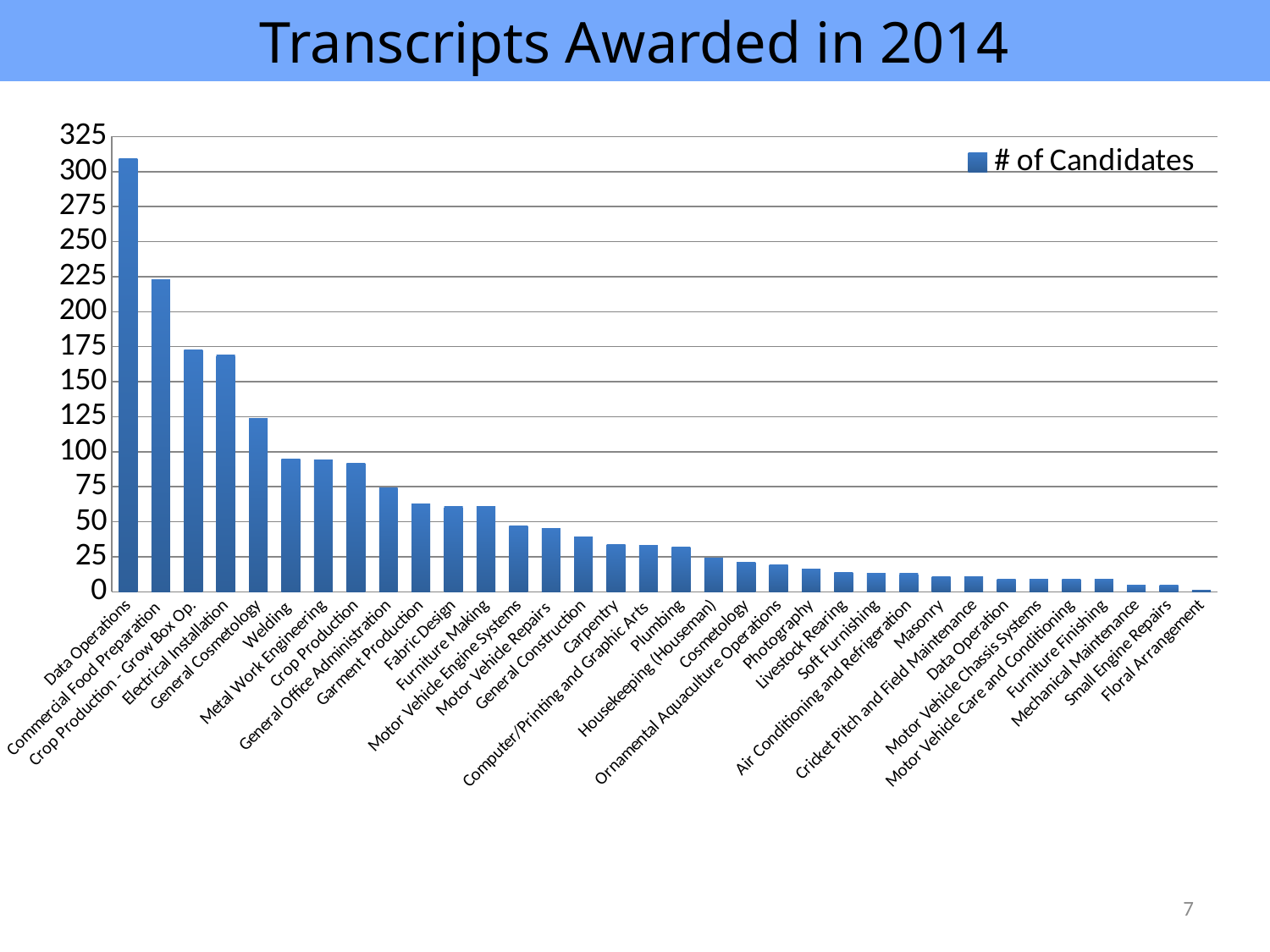
What is the name of the series shown in the legend? # of Candidates Is the value for Welding greater or less than 100? less What is the title of the chart? Transcripts Awarded in 2014 Which category has the lowest number of candidates? Floral Arrangement Which category has the highest number of candidates? Data Operations How many series does the legend list? 1 Which has more candidates, Commercial Food Preparation or Electrical Installation? Commercial Food Preparation Do the values rise or fall moving from left to right along the x axis? fall Is the value for Commercial Food Preparation greater or less than 200? greater Is the value for Garment Production greater or less than 50? greater What type of chart is shown on the slide? bar chart